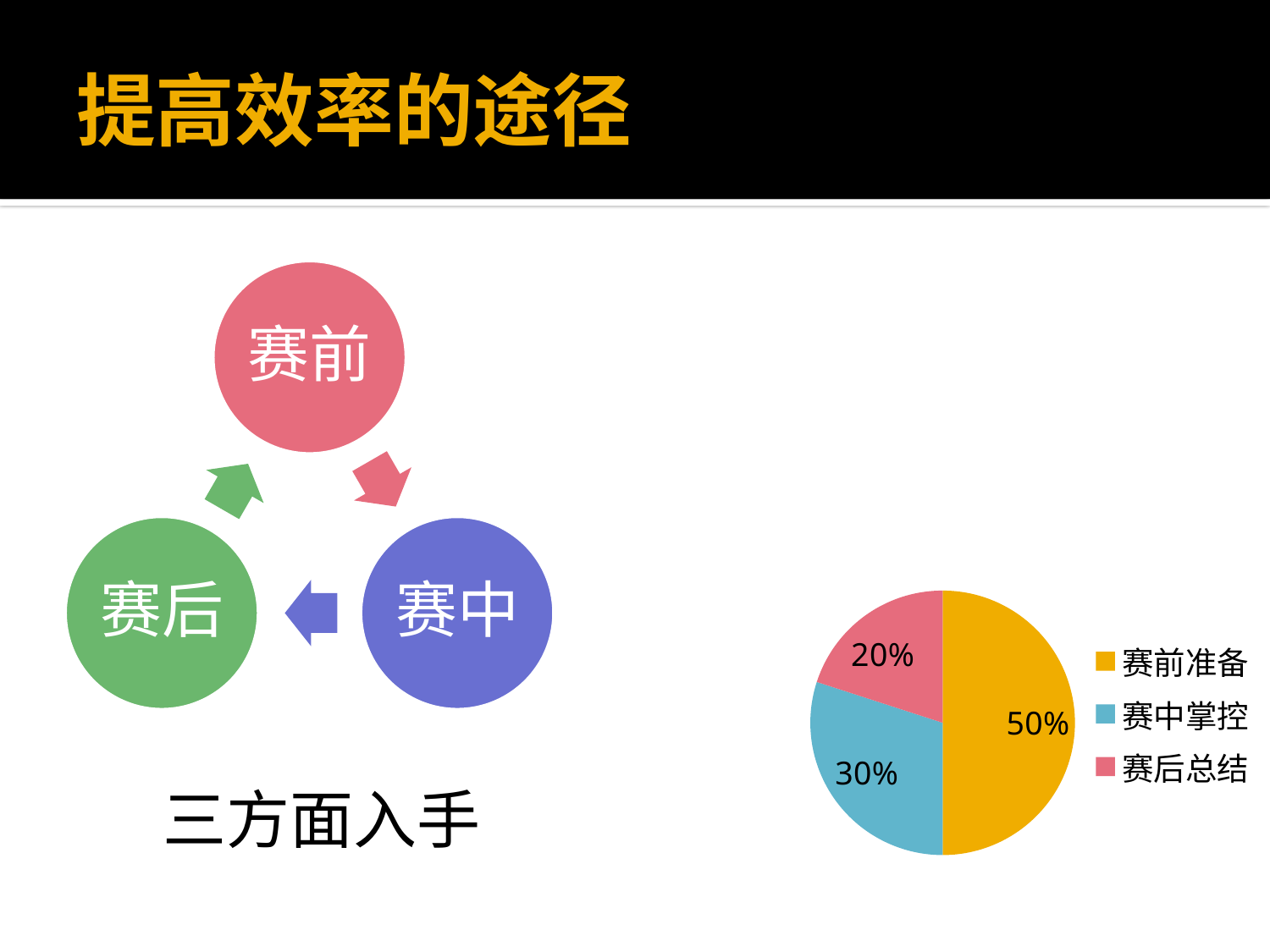
What share of the pie chart does 赛前准备 take? 50% What colour is the 赛前准备 slice in the pie chart? yellow What share of the pie chart does 赛中掌控 take? 30% Which category has the smallest slice in the pie chart? 赛后总结 Which is larger in the pie chart, 赛中掌控 or 赛后总结? 赛中掌控 What is the difference between the shares of 赛中掌控 and 赛后总结 in the pie chart? 10% What share of the pie chart does 赛后总结 take? 20% How many entries does the pie chart legend list? 3 Which category has the largest slice in the pie chart? 赛前准备 What kind of chart is shown on the right side of the slide? pie chart What is the difference between the shares of 赛前准备 and 赛中掌控 in the pie chart? 20% How many slices does the pie chart have? 3